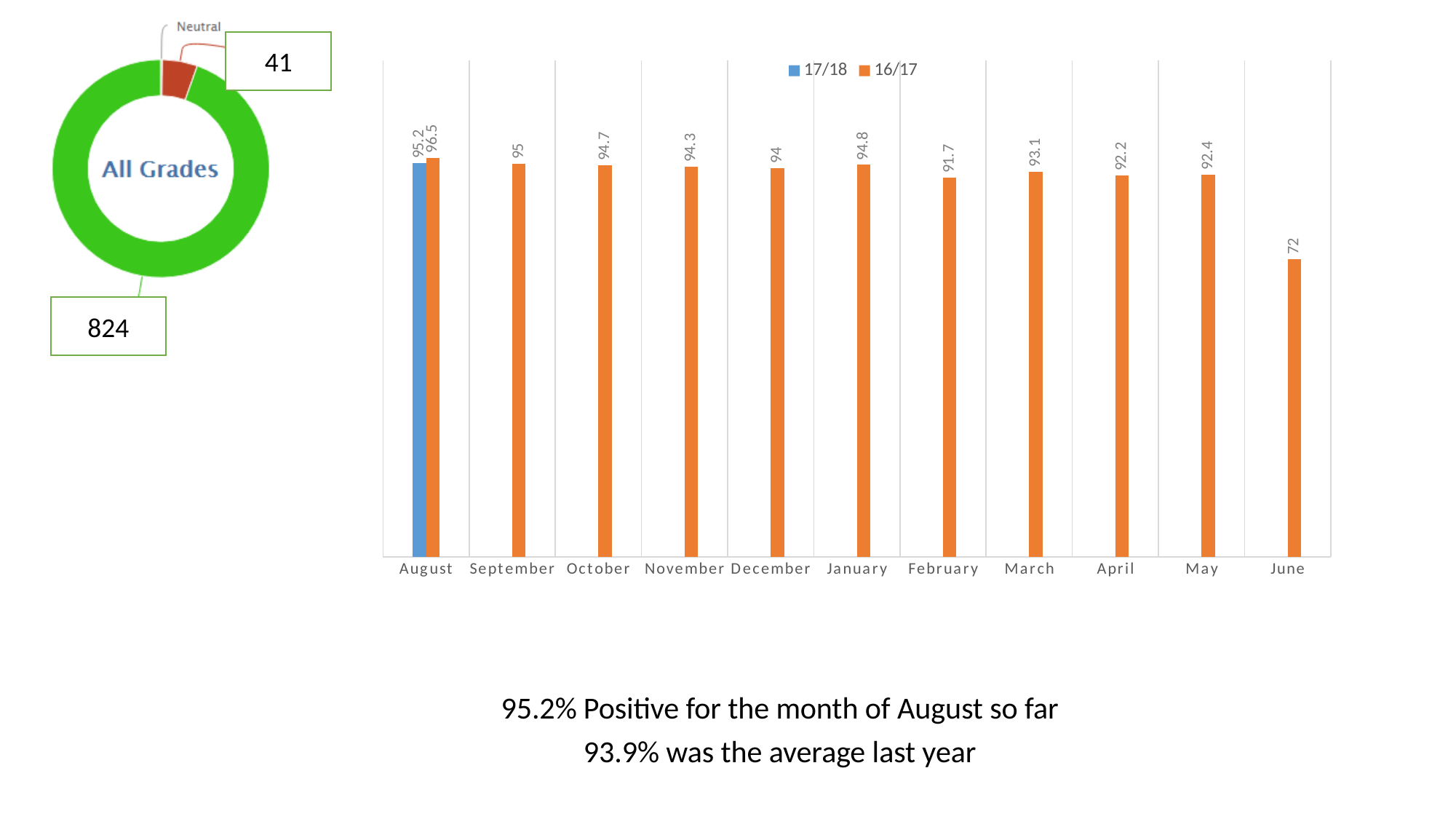
In the bar chart, which month has the lowest 16/17 value? June In the All Grades chart, what value is shown for the Neutral slice? 41 In the All Grades chart, what is the total of the two values shown? 865 In the bar chart, which month has the highest 16/17 value? August In the bar chart, what is the difference between the 16/17 values for May and June? 20.4 In the bar chart, how many months are shown on the x axis? 11 In the bar chart, which is larger for 16/17: February or March? March In the bar chart, how many series does the legend list? 2 In the bar chart, what is the 17/18 value for August? 95.2 In the bar chart, what is the 16/17 value for June? 72 What kind of chart is the chart on the right of the slide? Bar chart In the bar chart, what is the difference between the 16/17 and 17/18 values for August? 1.3